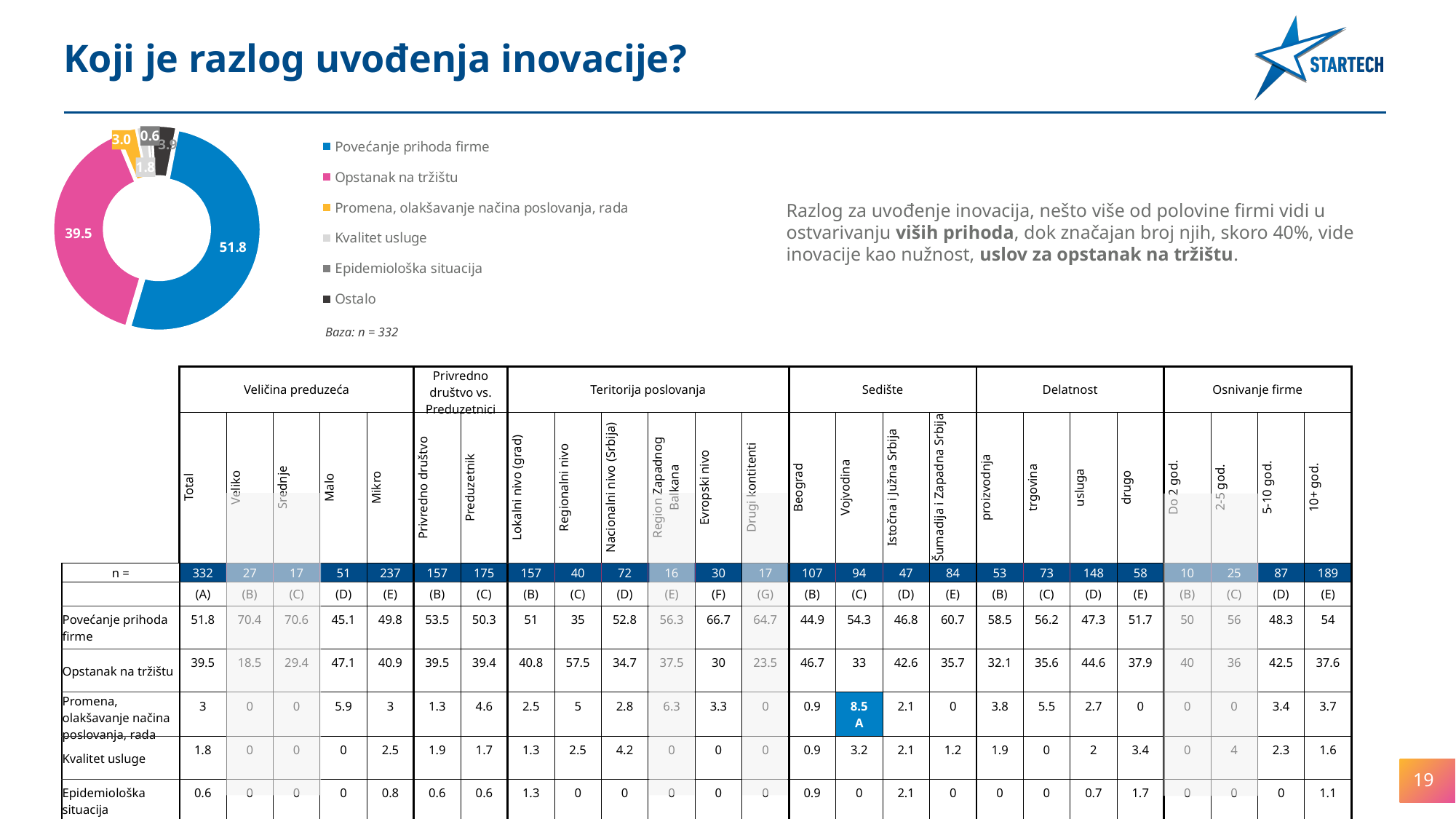
What kind of chart is shown at the top left of the slide? doughnut chart Which category has the largest slice in the pie chart? Povećanje prihoda firme In the pie chart, what is the value for Povećanje prihoda firme? 51.8 In the pie chart, what is the value for Opstanak na tržištu? 39.5 In the pie chart, what is the value for Ostalo? 3.9 In the pie chart, which is larger: Promena, olakšavanje načina poslovanja, rada or Kvalitet usluge? Promena, olakšavanje načina poslovanja, rada What is the base (n) stated below the pie chart legend? n = 332 In the pie chart, what is the difference between the values for Povećanje prihoda firme and Opstanak na tržištu? 12.3 How many slices does the pie chart have? 6 How many entries does the legend of the pie chart list? 6 In the pie chart, what is the value for Kvalitet usluge? 1.8 Which category has the smallest slice in the pie chart? Epidemiološka situacija